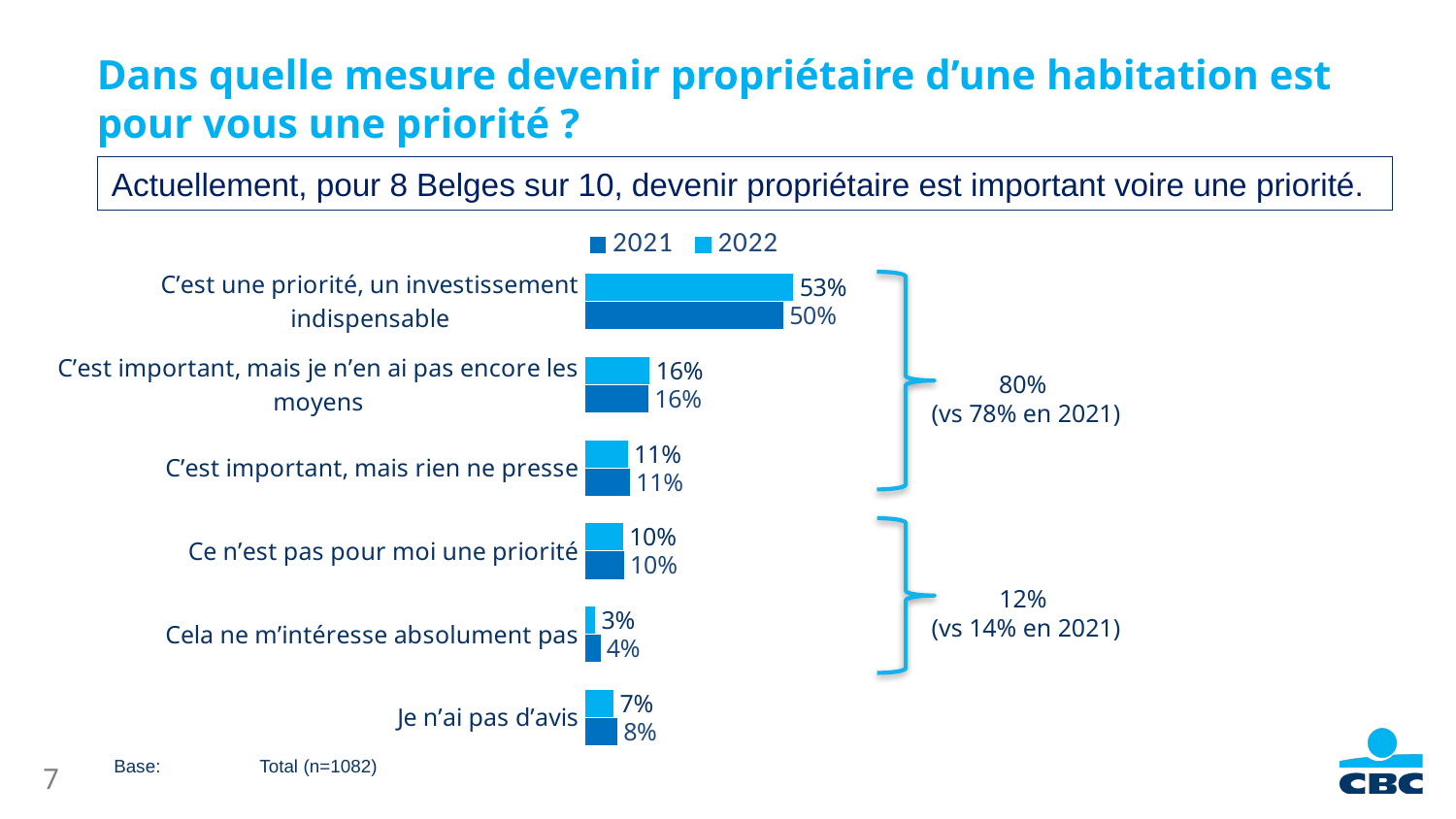
What is the 2021 value for "C'est une priorité, un investissement indispensable"? 50% What kind of chart is shown on the slide? Bar chart For "Je n'ai pas d'avis", which year has the larger value, 2021 or 2022? 2021 What is the 2021 value for "Je n'ai pas d'avis"? 8% What is the 2022 value for "C'est une priorité, un investissement indispensable"? 53% What is the 2022 value for "Cela ne m'intéresse absolument pas"? 3% Which category has the lowest 2022 value? Cela ne m'intéresse absolument pas Which series is shown in dark blue according to the legend? 2021 What is the difference between the 2022 and 2021 values for "C'est une priorité, un investissement indispensable"? 3 percentage points Which category has the highest 2022 value? C'est une priorité, un investissement indispensable How many categories are shown in the chart? 6 How many series does the legend list? 2